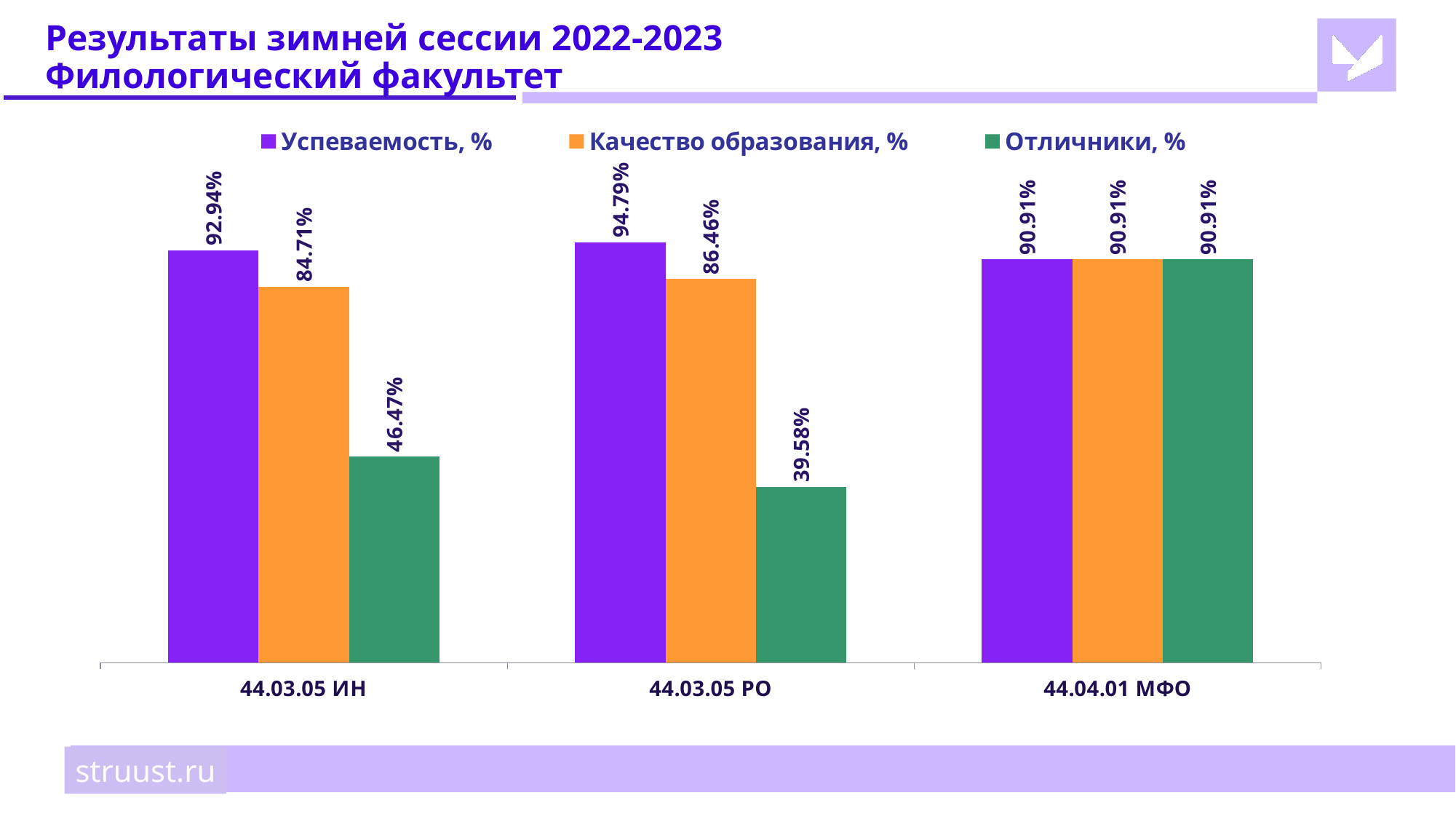
What is the value of Отличники, % for 44.03.05 РО? 39.58% What is the value of Успеваемость, % for 44.03.05 ИН? 92.94% Which is larger: Качество образования, % for 44.03.05 РО or for 44.03.05 ИН? 44.03.05 РО How many series does the legend list? 3 How many categories are shown on the x axis? 3 Which category has the highest value for Успеваемость, %? 44.03.05 РО What kind of chart is shown on the slide? Bar chart Which category has the lowest value for Отличники, %? 44.03.05 РО What is the difference between the Отличники, % values for 44.03.05 ИН and 44.03.05 РО? 6.89% What is the value of Качество образования, % for 44.04.01 МФО? 90.91% Which series is shown in orange in the legend? Качество образования, % What is the difference between Успеваемость, % and Качество образования, % for 44.03.05 ИН? 8.23%